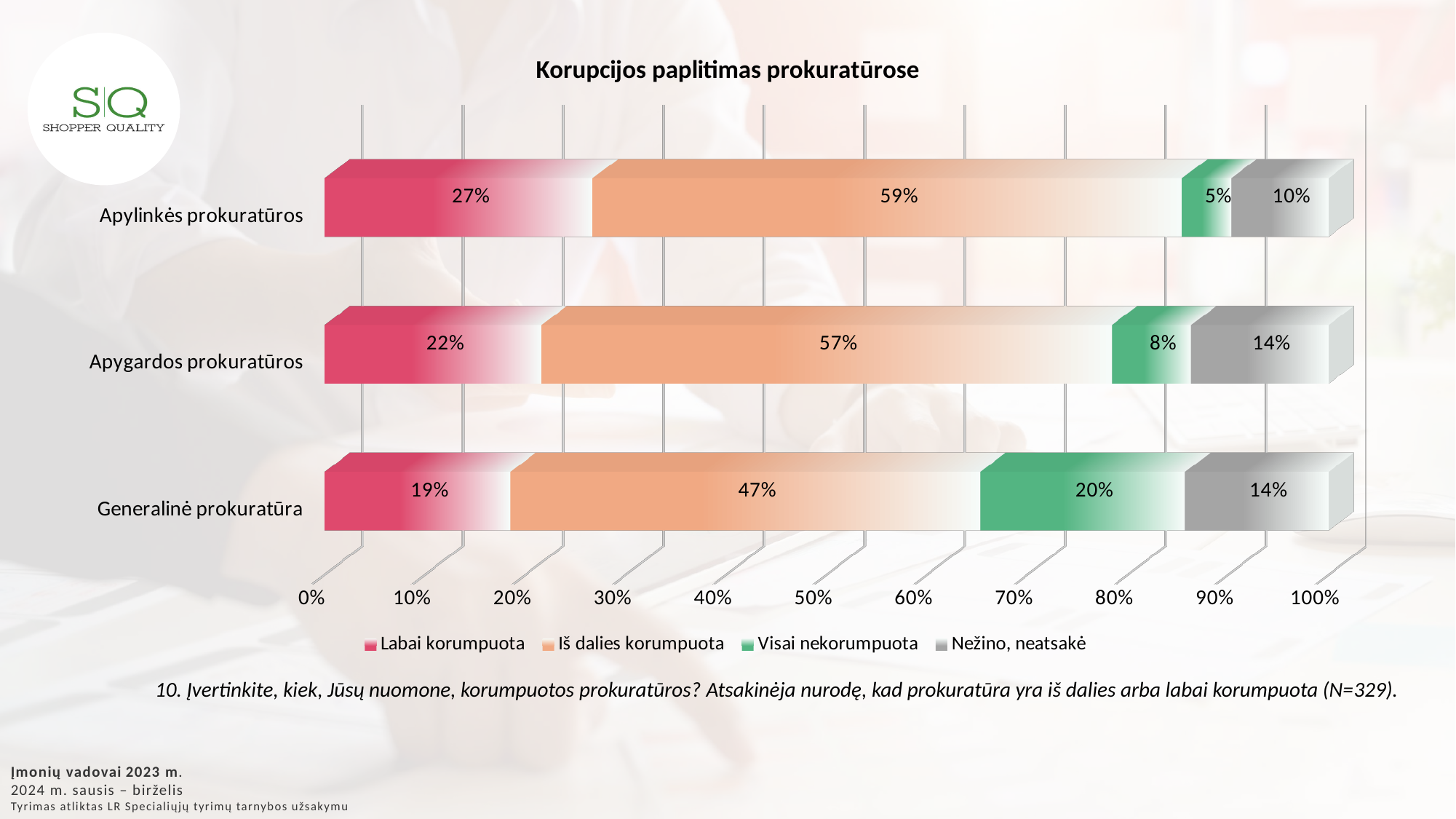
What is the title of the chart? Korupcijos paplitimas prokuratūrose What is the value for "Labai korumpuota" for Apylinkės prokuratūros? 27% Which is larger: the "Visai nekorumpuota" value for Apygardos prokuratūros or for Apylinkės prokuratūros? Apygardos prokuratūros What is the value for "Iš dalies korumpuota" for Apygardos prokuratūros? 57% How many series does the legend list? 4 What is the value for "Visai nekorumpuota" for Generalinė prokuratūra? 20% Which category has the highest value for "Visai nekorumpuota"? Generalinė prokuratūra What is the value for "Nežino, neatsakė" for Apylinkės prokuratūros? 10% Which category has the lowest value for "Labai korumpuota"? Generalinė prokuratūra How many categories are shown on the y axis? 3 What is the difference between the "Iš dalies korumpuota" values for Apylinkės prokuratūros and Generalinė prokuratūra? 12% What kind of chart is shown? Stacked bar chart